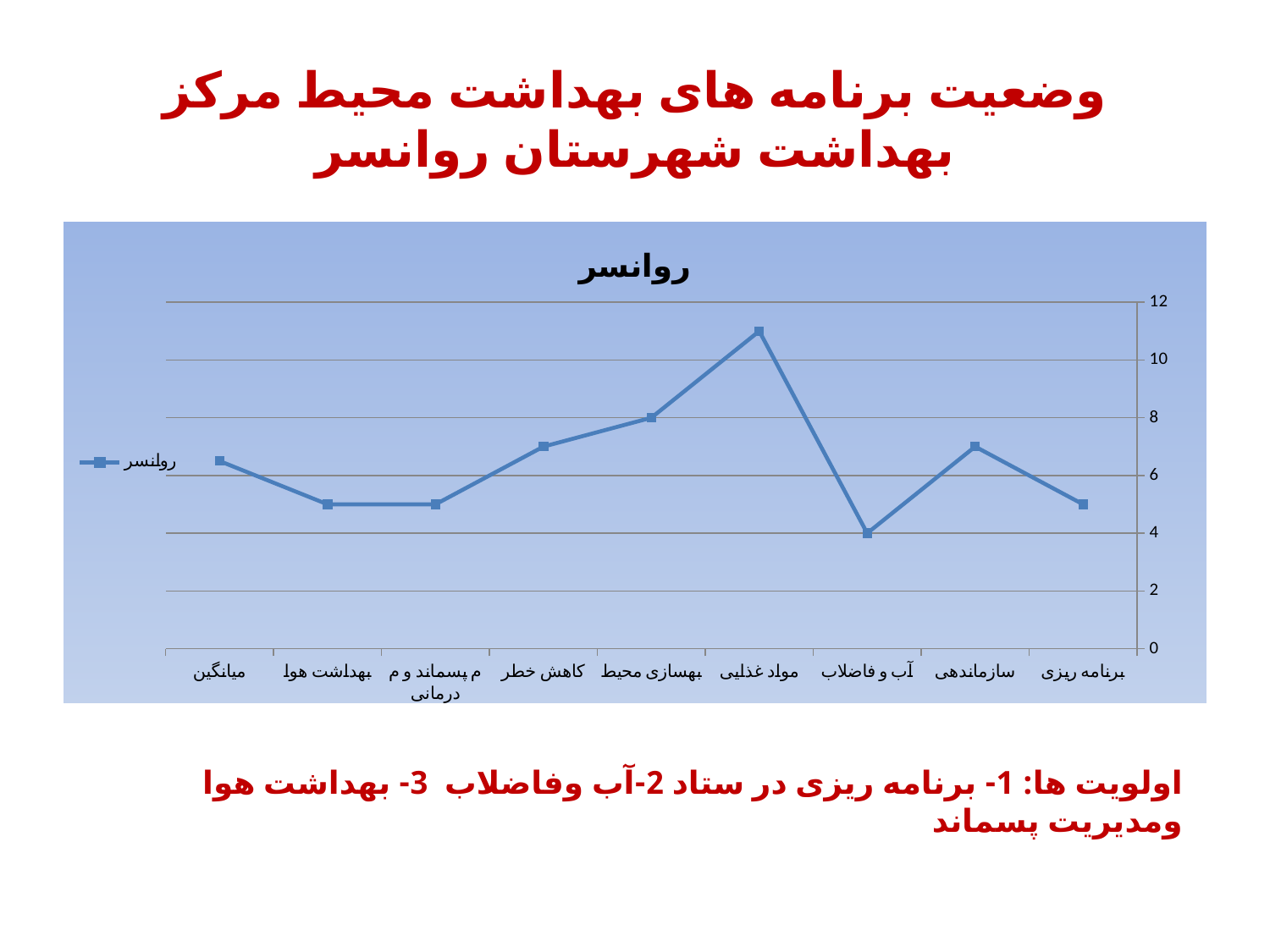
Which is larger, the value for سازماندهی or the value for آب و فاضلاب? سازماندهی How many categories are plotted along the x axis? 9 What is the title of the chart? روانسر What is the value for بهسازی محیط? 8 Is the value for مواد غذایی greater or less than 10? greater What kind of chart is shown on the slide? line chart What is the value for آب و فاضلاب? 4 How many series does the legend list? 1 Is the value for برنامه ریزی greater or less than 6? less What is the difference between the values for بهسازی محیط and آب و فاضلاب? 4 Which category has the lowest value? آب و فاضلاب Which category has the highest value? مواد غذایی